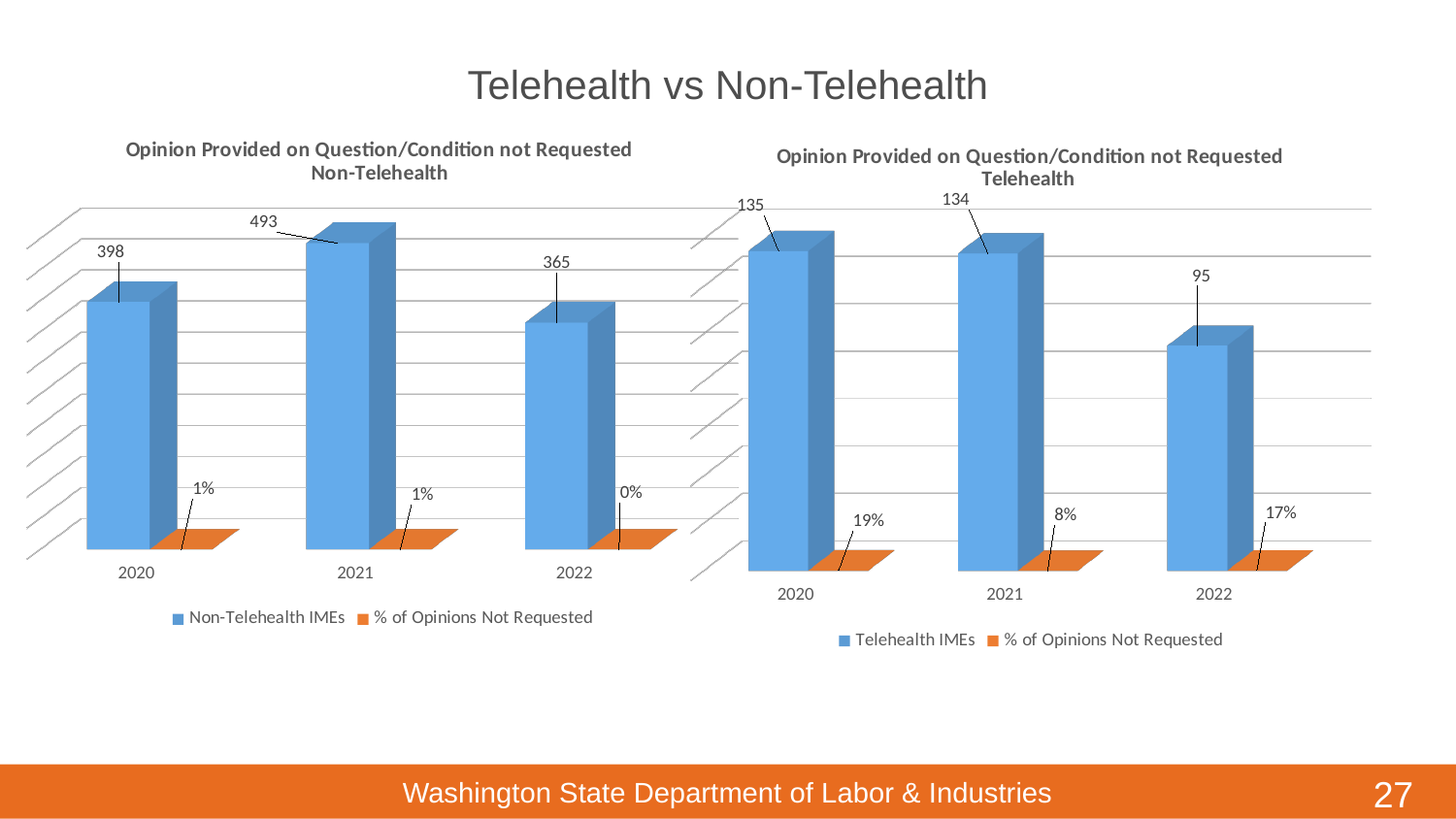
How many series does the legend of the Non-Telehealth chart list? 2 How many years are shown on the x axis of the Telehealth chart? 3 What type of chart is the Telehealth chart? Bar chart In the Non-Telehealth chart, which year has the highest number of Non-Telehealth IMEs? 2021 In the Telehealth chart, what is the value of Telehealth IMEs for 2022? 95 In the Telehealth chart, what is the % of Opinions Not Requested for 2020? 19% In the Telehealth chart, what is the difference between Telehealth IMEs in 2020 and 2022? 40 In the Non-Telehealth chart, what is the % of Opinions Not Requested for 2022? 0% In the Telehealth chart, which year has the lowest number of Telehealth IMEs? 2022 In the Telehealth chart, which year has a larger % of Opinions Not Requested, 2021 or 2022? 2022 In the Non-Telehealth chart, what is the difference between Non-Telehealth IMEs in 2021 and 2022? 128 In the Non-Telehealth chart, what is the value of Non-Telehealth IMEs for 2021? 493